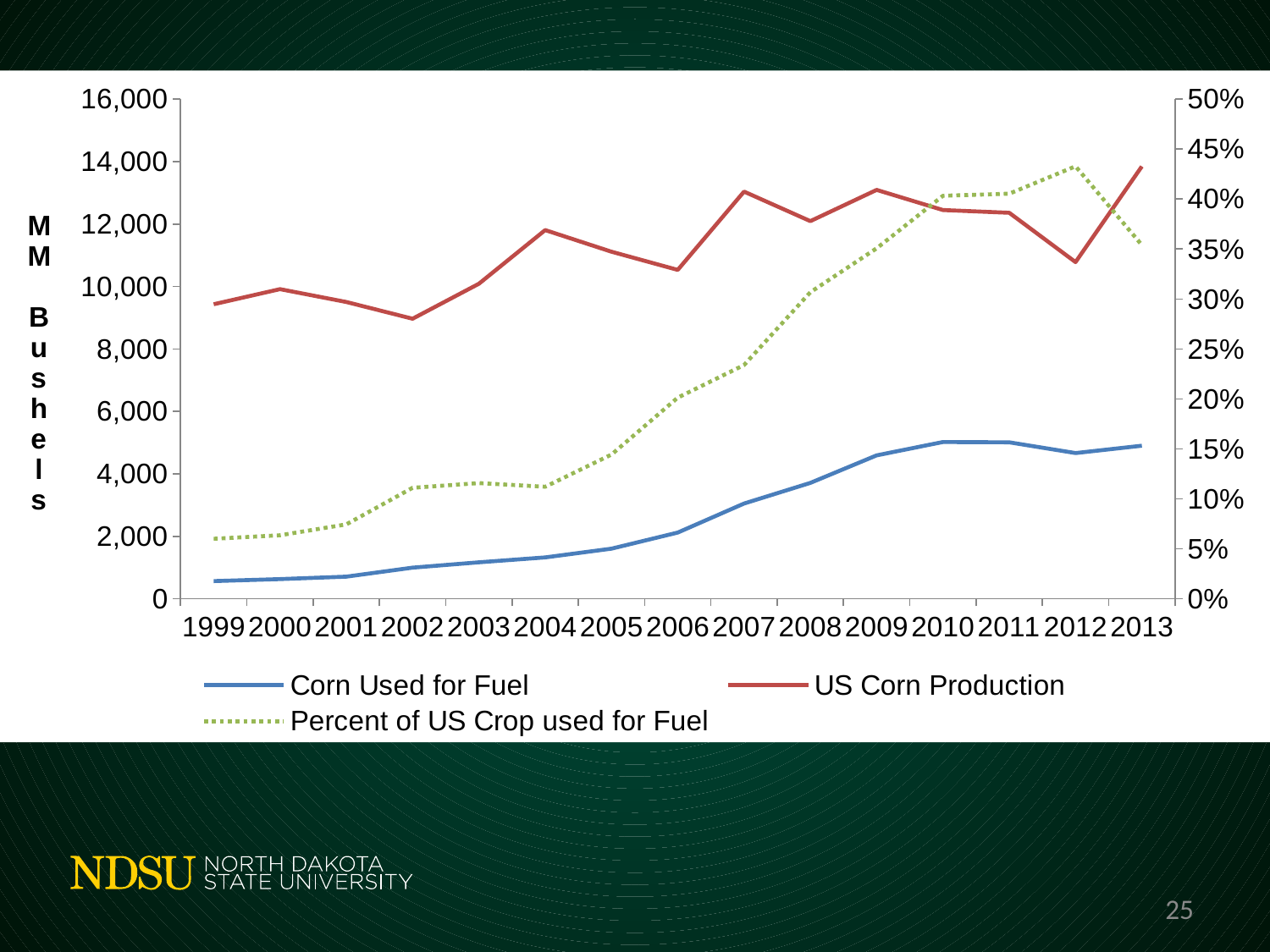
How many years are plotted along the x axis? 15 Is the value for Percent of US Crop used for Fuel in 2012 greater or less than 40%? greater Is the value for Corn Used for Fuel in 1999 greater or less than 2,000? less What kind of chart is shown on the slide? line chart How many series does the legend list? 3 What is the label on the left vertical axis? MM Bushels Is the value for US Corn Production in 2002 greater or less than 10,000? less In which year is US Corn Production highest? 2013 Which series is drawn with a dotted line? Percent of US Crop used for Fuel Does Corn Used for Fuel rise or fall from 1999 to 2010? rise In which year is Percent of US Crop used for Fuel highest? 2012